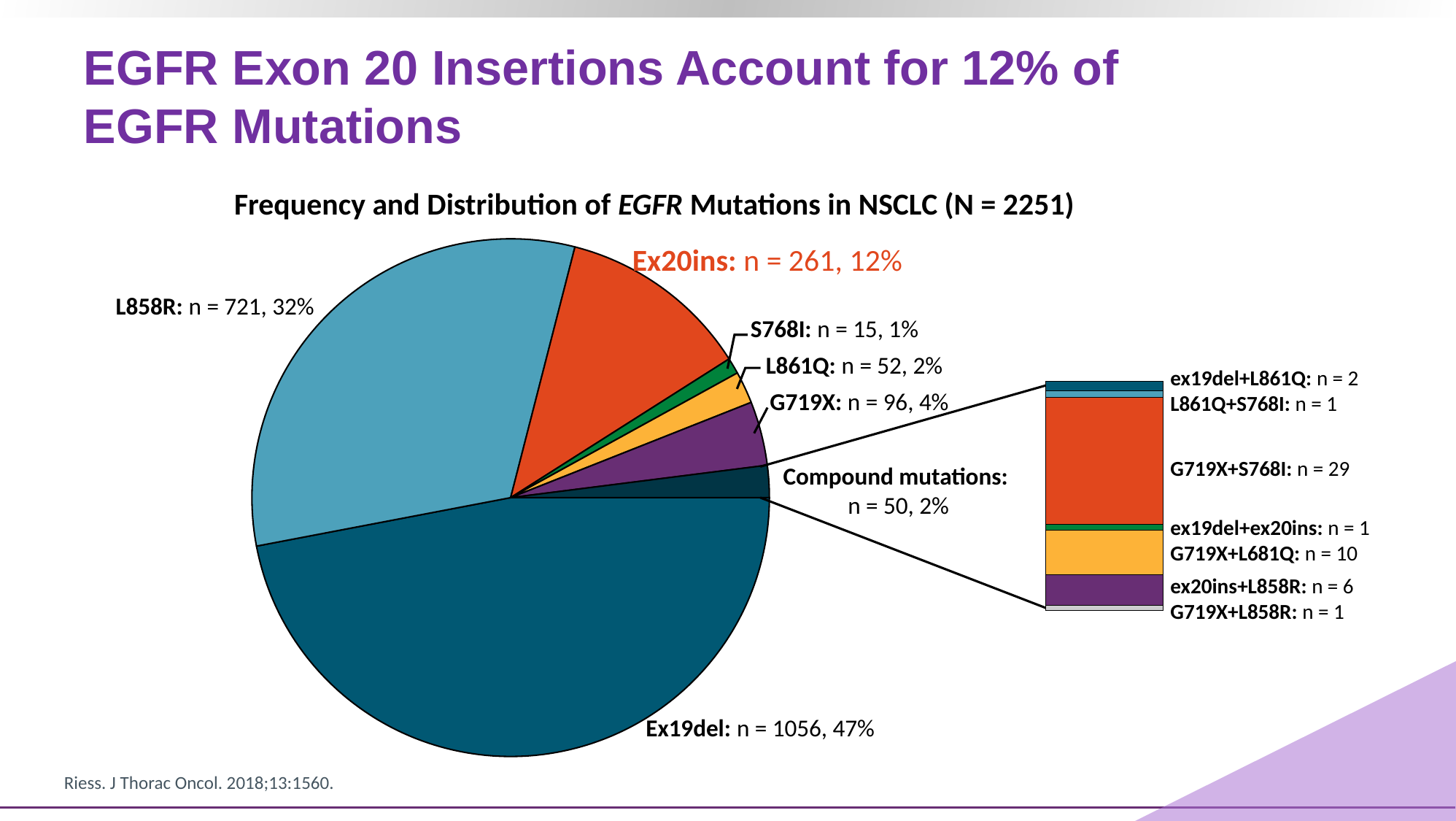
In the compound mutations breakdown, what is the n for G719X+L681Q? 10 What is the title of the chart? Frequency and Distribution of EGFR Mutations in NSCLC (N = 2251) What is the total n for compound mutations? 50 How many slices does the pie chart have? 7 In the compound mutations breakdown, which combination has the highest n? G719X+S768I Which mutation category has the smallest slice of the pie? S768I How many patients (n) have the Ex20ins mutation? 261 What percentage of EGFR mutations are L858R? 32% Which mutation category has the largest slice of the pie? Ex19del What type of chart is the main chart on the slide? pie chart Which is larger, the n for G719X or the n for L861Q? G719X What is the difference in n between Ex19del and L858R? 335